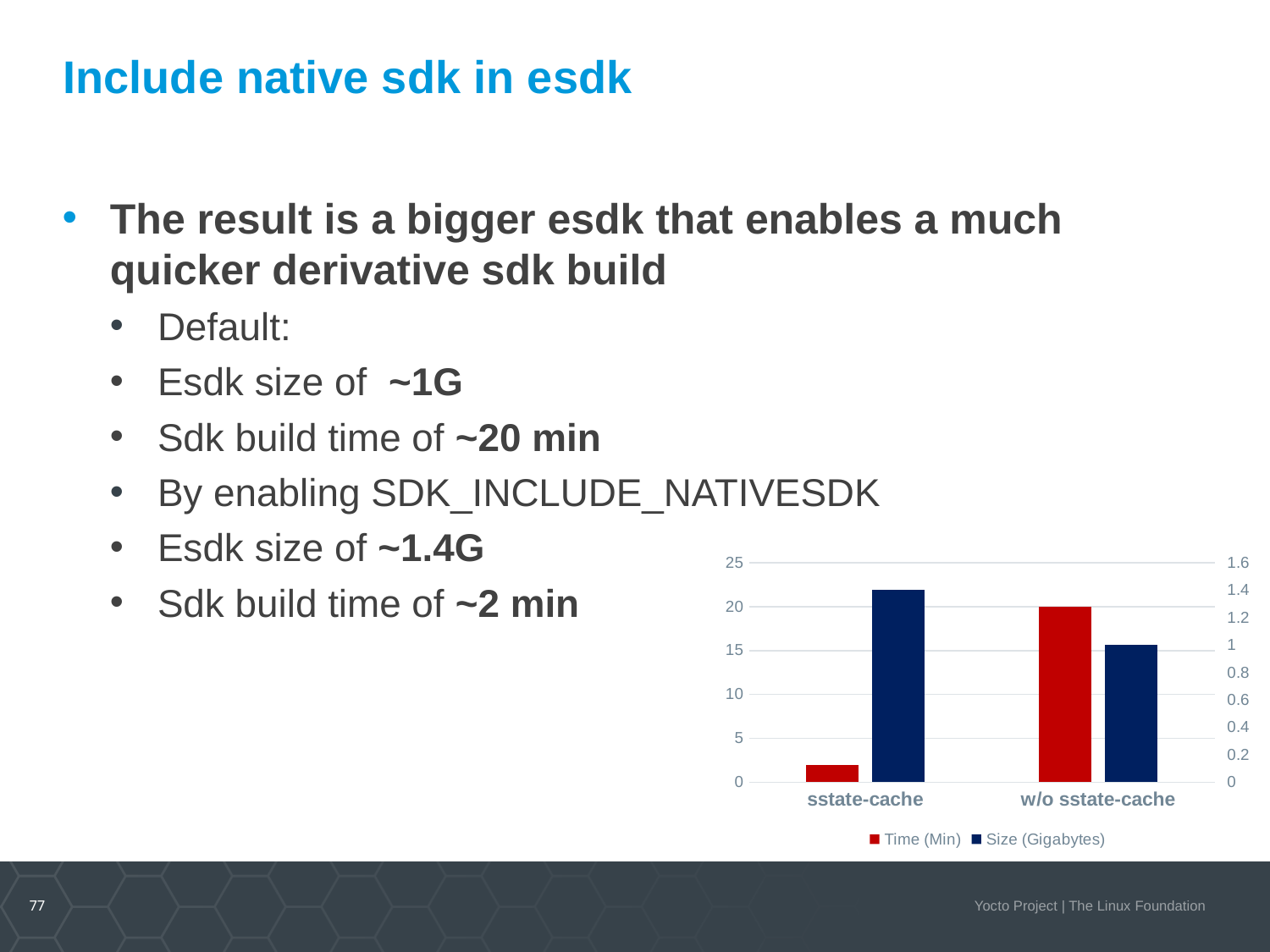
Which category has the lowest Time (Min) value? sstate-cache Is the Time (Min) value for w/o sstate-cache greater or less than 15? greater Which category has the higher Size (Gigabytes) value, sstate-cache or w/o sstate-cache? sstate-cache How many series does the chart legend list? 2 Is the Size (Gigabytes) value for w/o sstate-cache greater or less than 1.2? less Is the Size (Gigabytes) value for sstate-cache greater or less than 1.2? greater What are the two series listed in the chart legend? Time (Min) and Size (Gigabytes) Which category has the higher Time (Min) value, sstate-cache or w/o sstate-cache? w/o sstate-cache What kind of chart is shown on the slide? bar chart Which colour represents the Time (Min) series in the chart? red How many categories are shown on the x axis of the chart? 2